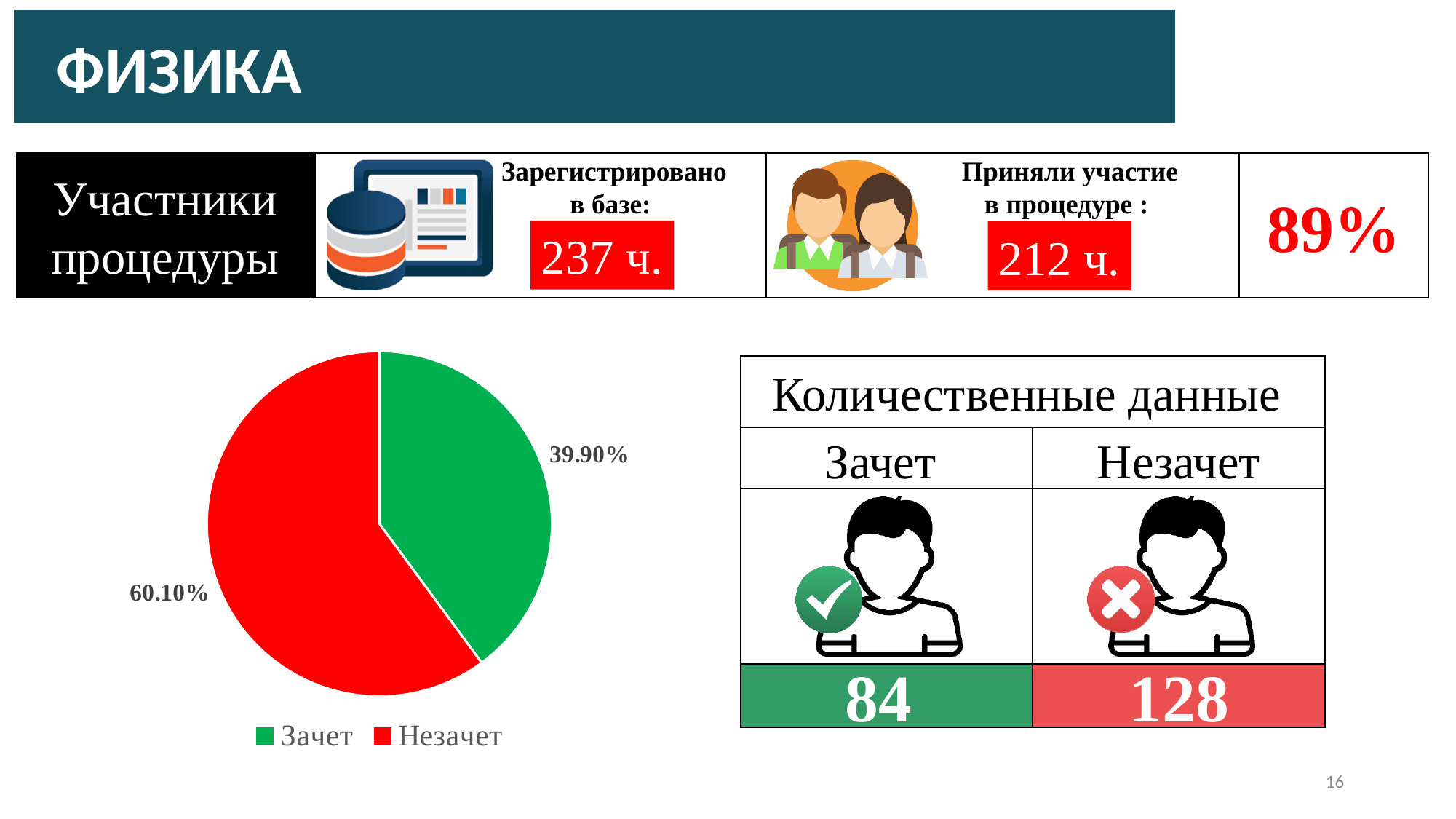
Which is larger in the pie chart, Зачет or Незачет? Незачет What share of the pie chart does Зачет represent? 39.90% Which slice of the pie chart is the largest? Незачет What share of the pie chart does Незачет represent? 60.10% How many entries does the pie chart's legend list? 2 How many slices does the pie chart have? 2 What colour is the Незачет slice in the pie chart? red What colour is the Зачет slice in the pie chart? green What is the difference in percentage points between the Незачет and Зачет slices of the pie chart? 20.20% What kind of chart is shown on the slide? pie chart Is the Незачет slice of the pie chart more or less than half of the pie? more Which slice of the pie chart is the smallest? Зачет